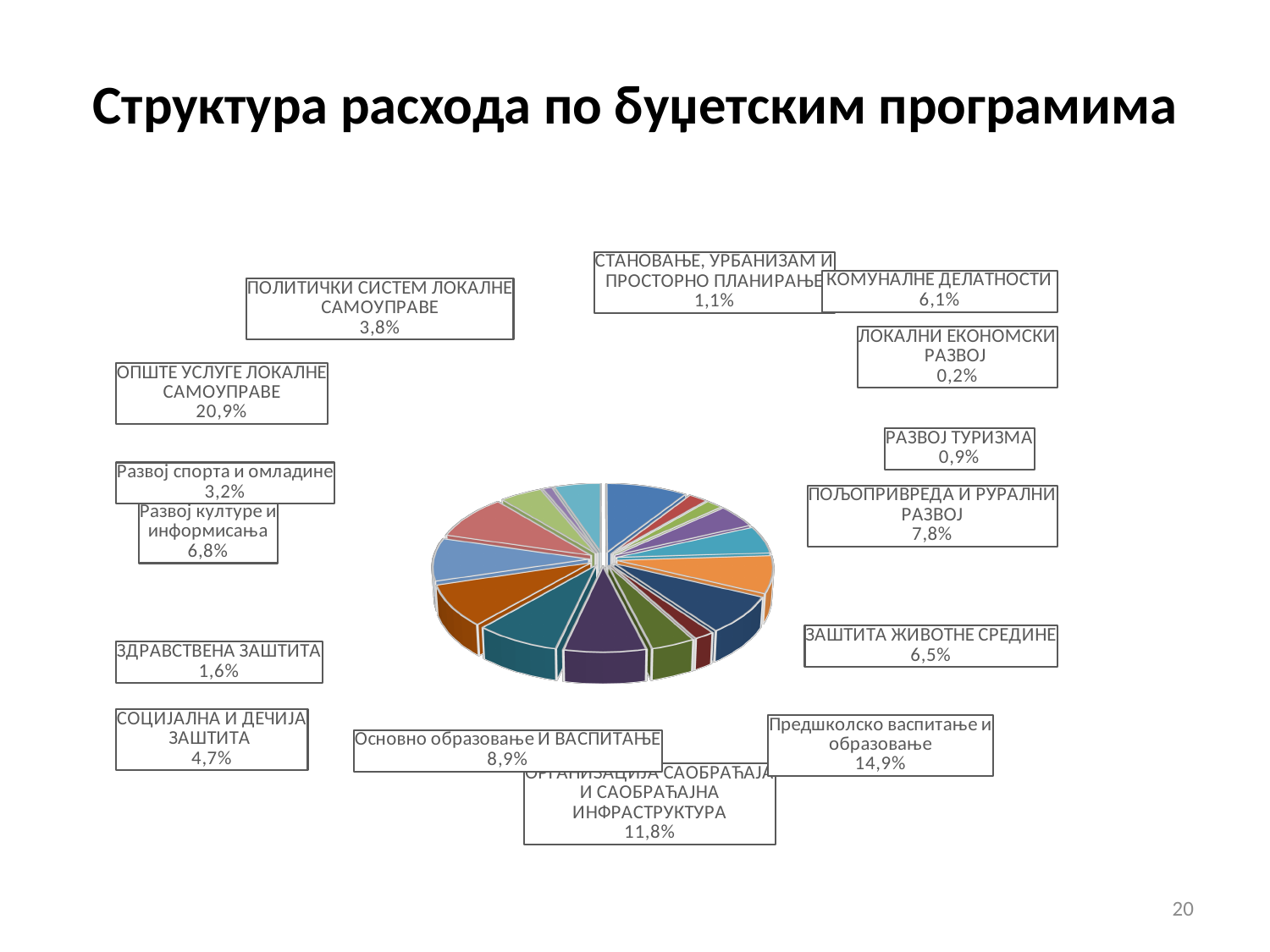
Which budget programme has the largest share of expenditure? ОПШТЕ УСЛУГЕ ЛОКАЛНЕ САМОУПРАВЕ What share of expenditure goes to ОПШТЕ УСЛУГЕ ЛОКАЛНЕ САМОУПРАВЕ? 20,9% What is the title of the chart on the slide? Структура расхода по буџетским програмима Which budget programme has the smallest share of expenditure? ЛОКАЛНИ ЕКОНОМСКИ РАЗВОЈ How many percentage points larger is the share for ОПШТЕ УСЛУГЕ ЛОКАЛНЕ САМОУПРАВЕ than for Предшколско васпитање и образовање? 6,0% How many budget programmes are labelled on the pie chart? 15 What is the difference between the shares for ОРГАНИЗАЦИЈА САОБРАЋАЈА И САОБРАЋАЈНА ИНФРАСТРУКТУРА and Основно образовање И ВАСПИТАЊЕ? 2,9% What percentage is shown for Предшколско васпитање и образовање? 14,9% What percentage is shown for РАЗВОЈ ТУРИЗМА? 0,9% What percentage is shown for ОРГАНИЗАЦИЈА САОБРАЋАЈА И САОБРАЋАЈНА ИНФРАСТРУКТУРА? 11,8% What kind of chart is shown on the slide? Pie chart Which has the larger share: Развој културе и информисања or Развој спорта и омладине? Развој културе и информисања